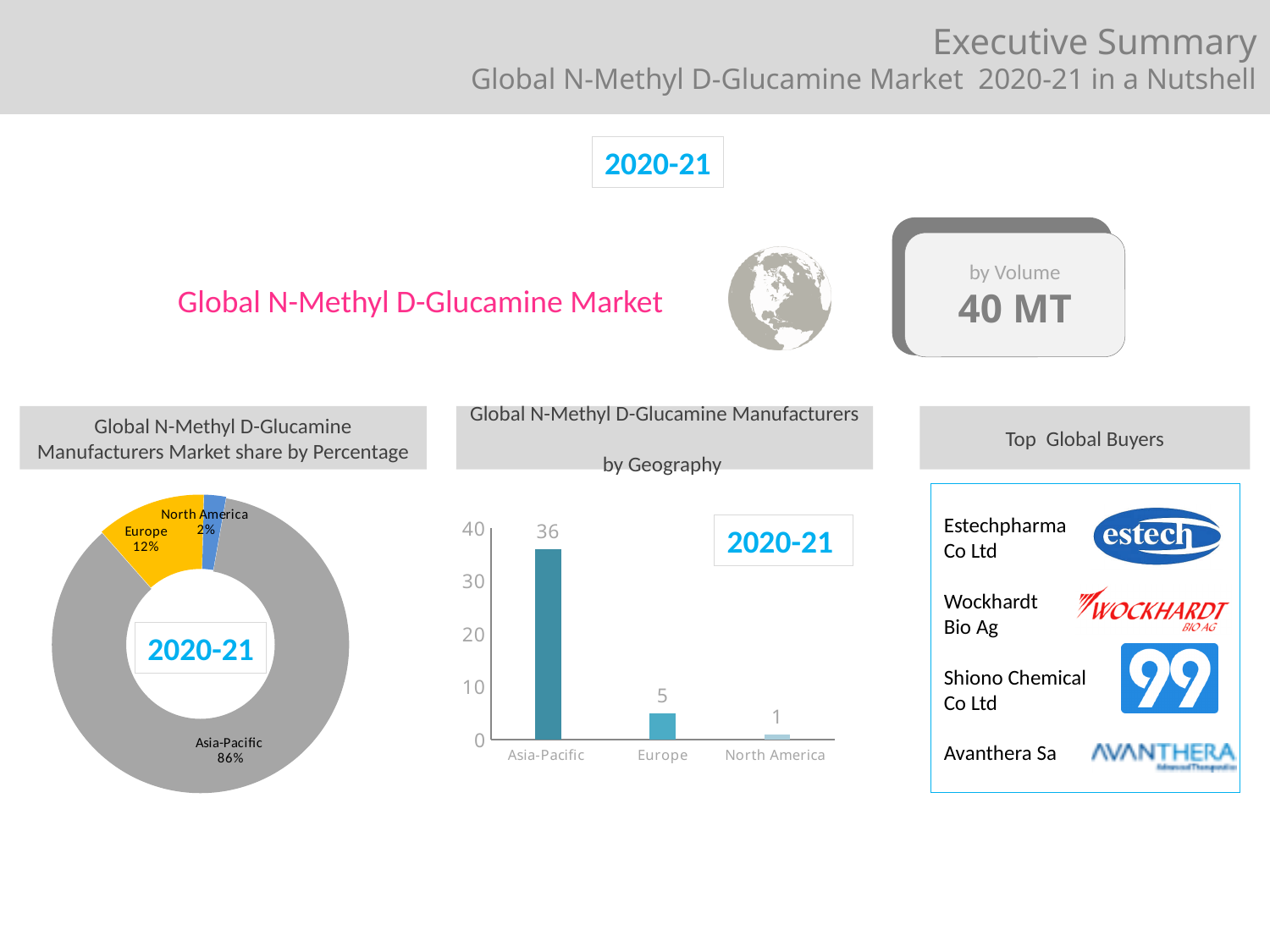
In the 'Global N-Methyl D-Glucamine Manufacturers Market share by Percentage' chart, which region has the smallest share? North America In the 'Global N-Methyl D-Glucamine Manufacturers by Geography' chart, what is the value for Asia-Pacific? 36 In the 'Global N-Methyl D-Glucamine Manufacturers by Geography' chart, which region has the highest value? Asia-Pacific What kind of chart is the 'Global N-Methyl D-Glucamine Manufacturers by Geography' chart? Bar chart In the 'Global N-Methyl D-Glucamine Manufacturers by Geography' chart, what is the value for Europe? 5 What kind of chart is the 'Global N-Methyl D-Glucamine Manufacturers Market share by Percentage' chart? Doughnut (pie) chart In the 'Global N-Methyl D-Glucamine Manufacturers Market share by Percentage' chart, what is the share for North America? 2% How many categories are shown in the 'Global N-Methyl D-Glucamine Manufacturers by Geography' chart? 3 In the 'Global N-Methyl D-Glucamine Manufacturers Market share by Percentage' chart, what is the share for Asia-Pacific? 86% In the 'Global N-Methyl D-Glucamine Manufacturers by Geography' chart, what is the difference between the values for Asia-Pacific and Europe? 31 In the 'Global N-Methyl D-Glucamine Manufacturers by Geography' chart, what is the value for North America? 1 In the 'Global N-Methyl D-Glucamine Manufacturers Market share by Percentage' chart, what is the share for Europe? 12%